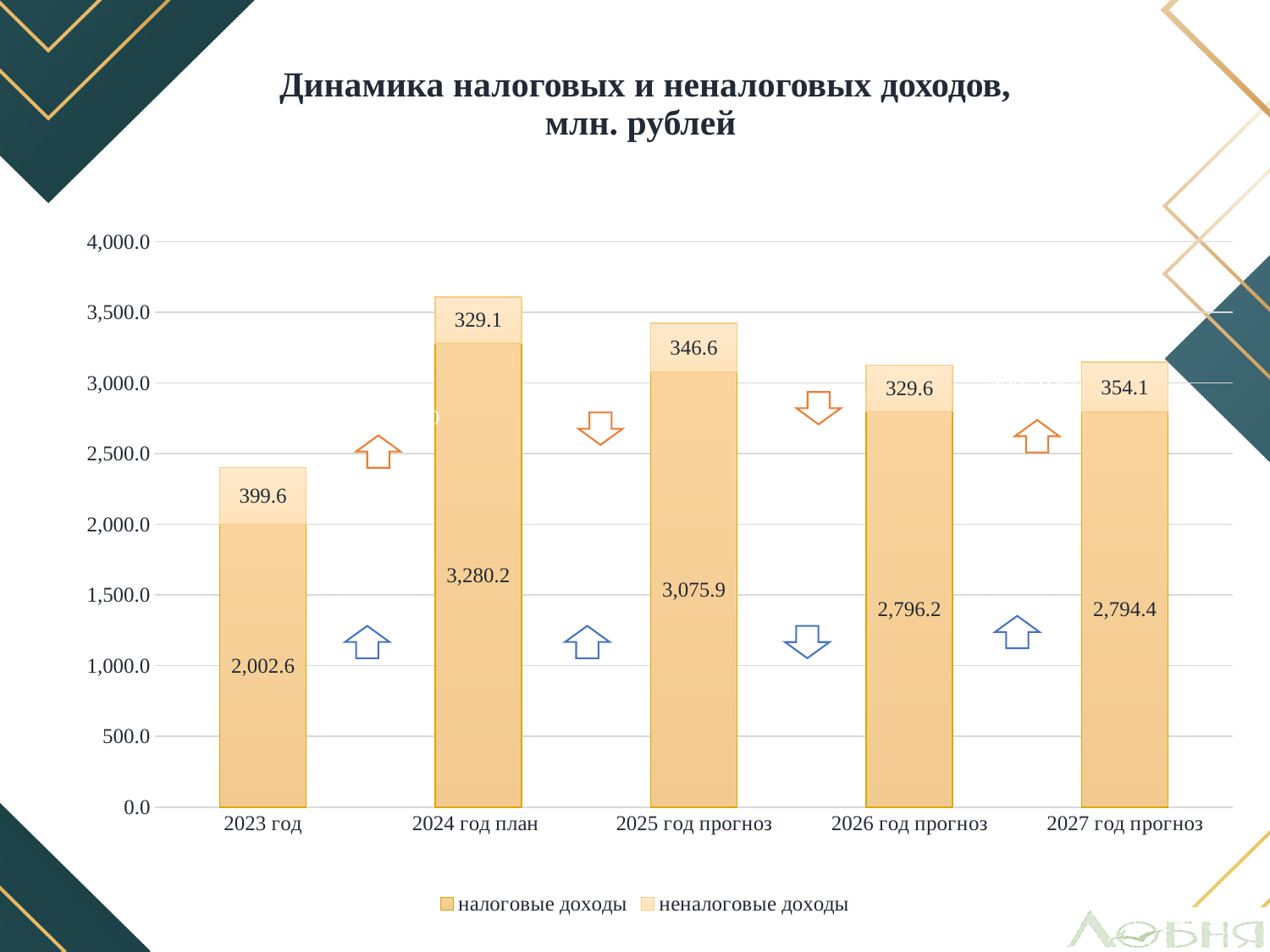
How many categories are shown on the x axis? 5 Which category has the highest value for налоговые доходы? 2024 год план What is the difference between налоговые доходы for 2024 год план and 2023 год? 1,277.6 Is the total of the stacked bar for 2024 год план greater or less than 3,500.0? greater What is the total of the stacked bar for 2023 год? 2,402.2 How many series does the legend list? 2 What is the value of налоговые доходы for 2024 год план? 3,280.2 What is the value of налоговые доходы for 2023 год? 2,002.6 Which category has the highest value for неналоговые доходы? 2023 год Which category has the lowest value for налоговые доходы? 2023 год Which is larger: налоговые доходы for 2025 год прогноз or for 2026 год прогноз? 2025 год прогноз What is the value of неналоговые доходы for 2027 год прогноз? 354.1